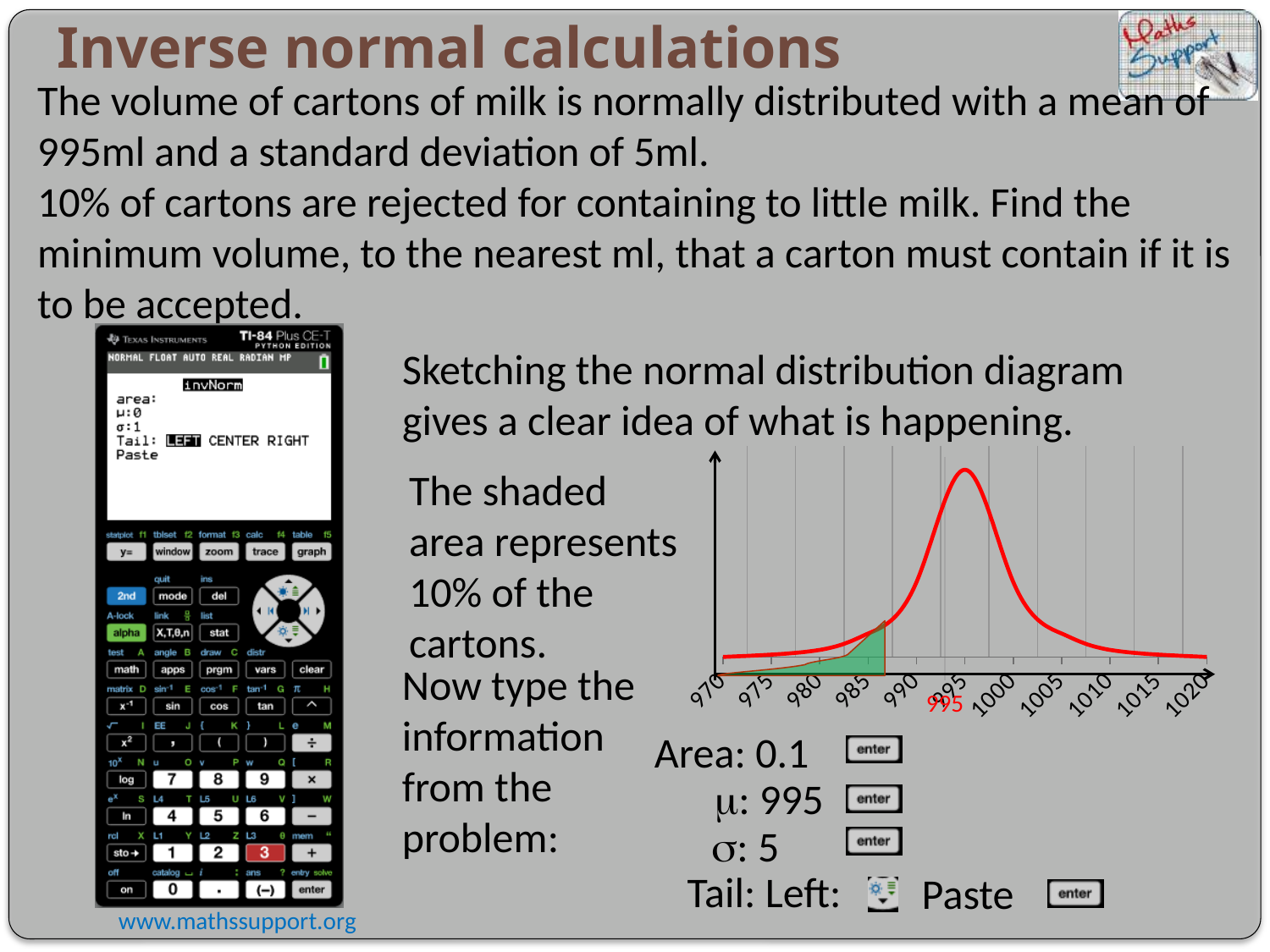
Does the curve rise or fall as x increases from 970 to 995? rise What kind of chart is shown on the slide? line chart (normal distribution curve) How many labelled tick values are shown on the x axis of the normal distribution diagram? 11 Does the curve rise or fall as x increases from 995 to 1020? fall Which value on the x axis is highlighted in red? 995 What percentage of the cartons does the shaded area under the curve represent? 10% Is the shaded region under the curve to the left or to the right of 990 on the x axis? left At which x-axis value does the normal curve reach its peak? 995 What is the highest value labelled on the x axis of the diagram? 1020 What is the lowest value labelled on the x axis of the diagram? 970 What is the step between consecutive labelled ticks on the x axis? 5 What colour is the shaded region under the curve? green